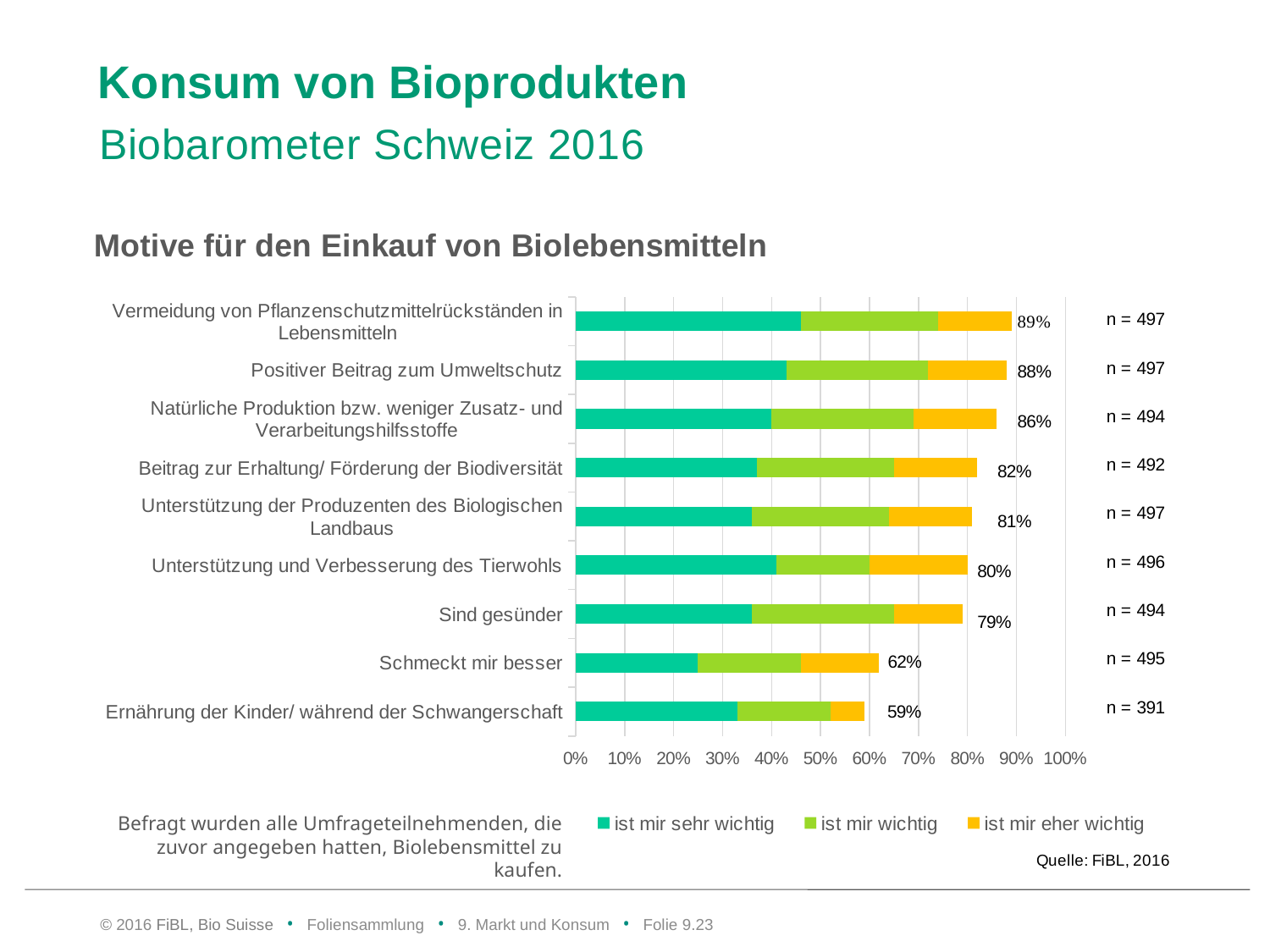
What kind of chart is shown on the slide? Stacked bar chart Which has a higher total percentage: "Unterstützung und Verbesserung des Tierwohls" or "Schmeckt mir besser"? Unterstützung und Verbesserung des Tierwohls Which motive has the highest total percentage? Vermeidung von Pflanzenschutzmittelrückständen in Lebensmitteln What total percentage is shown for "Sind gesünder"? 79% What total percentage is shown for "Positiver Beitrag zum Umweltschutz"? 88% How many motives (categories) are shown in the chart? 9 Which motive has the lowest total percentage? Ernährung der Kinder/ während der Schwangerschaft Is the "ist mir sehr wichtig" segment for "Schmeckt mir besser" greater or less than 30%? less What total percentage is shown for "Ernährung der Kinder/ während der Schwangerschaft"? 59% What is the difference between the total percentages for "Beitrag zur Erhaltung/ Förderung der Biodiversität" and "Schmeckt mir besser"? 20% How many series does the legend list? 3 What is the sample size (n) shown for "Ernährung der Kinder/ während der Schwangerschaft"? n = 391